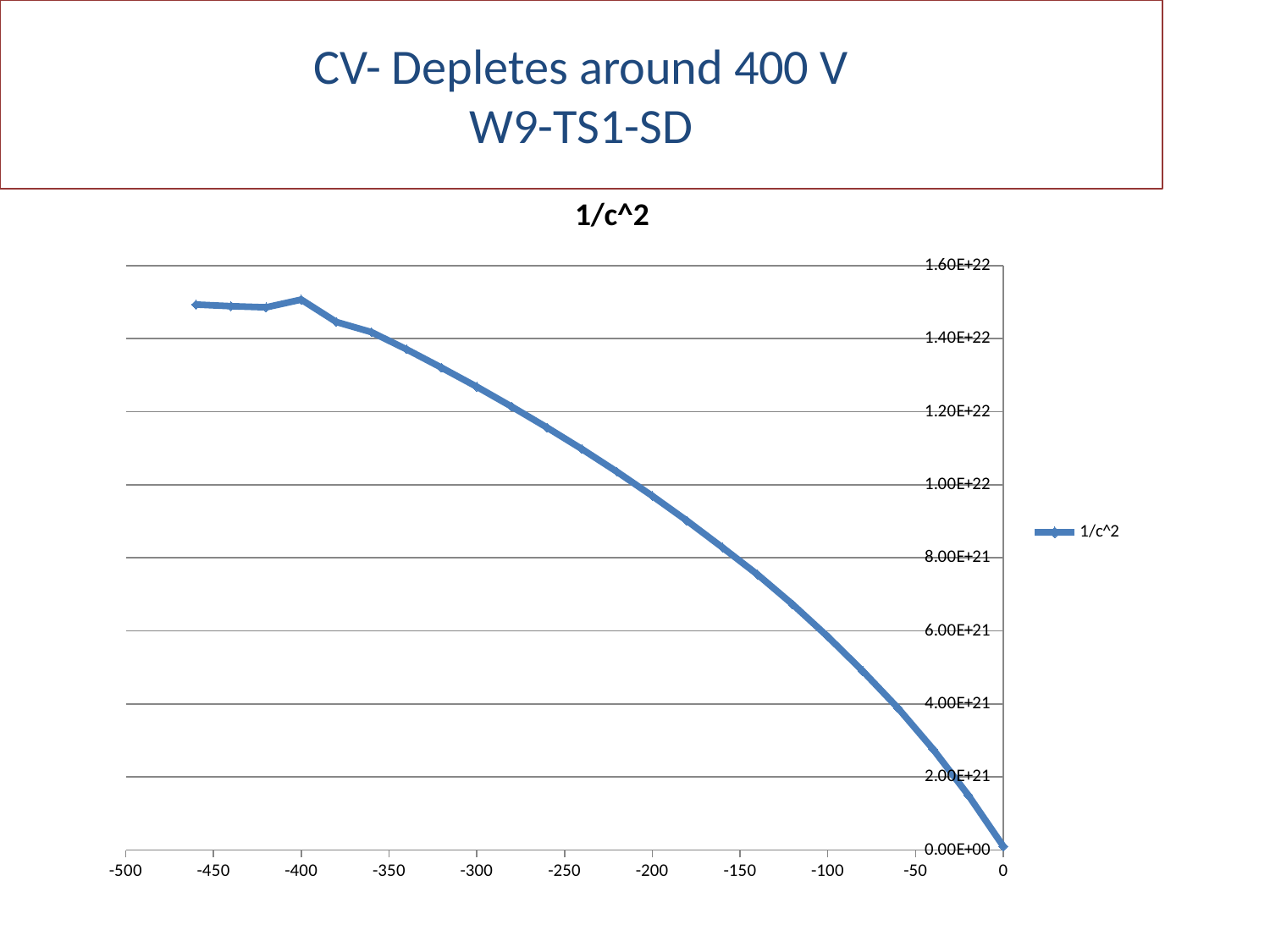
How many series does the legend list? 1 Is the value of 1/c^2 at x = -450 greater or less than 1.40E+22? greater What kind of chart is shown on the slide? line chart What is the title of the chart? 1/c^2 Is the value of 1/c^2 at x = -400 greater or less than 1.40E+22? greater Is the value of 1/c^2 at x = -50 greater or less than 4.00E+21? less Which is larger, the value of 1/c^2 at x = -300 or at x = -100? x = -300 Do the values of 1/c^2 rise or fall as x increases from -400 to 0? fall At which x value does the 1/c^2 curve reach its lowest point? 0